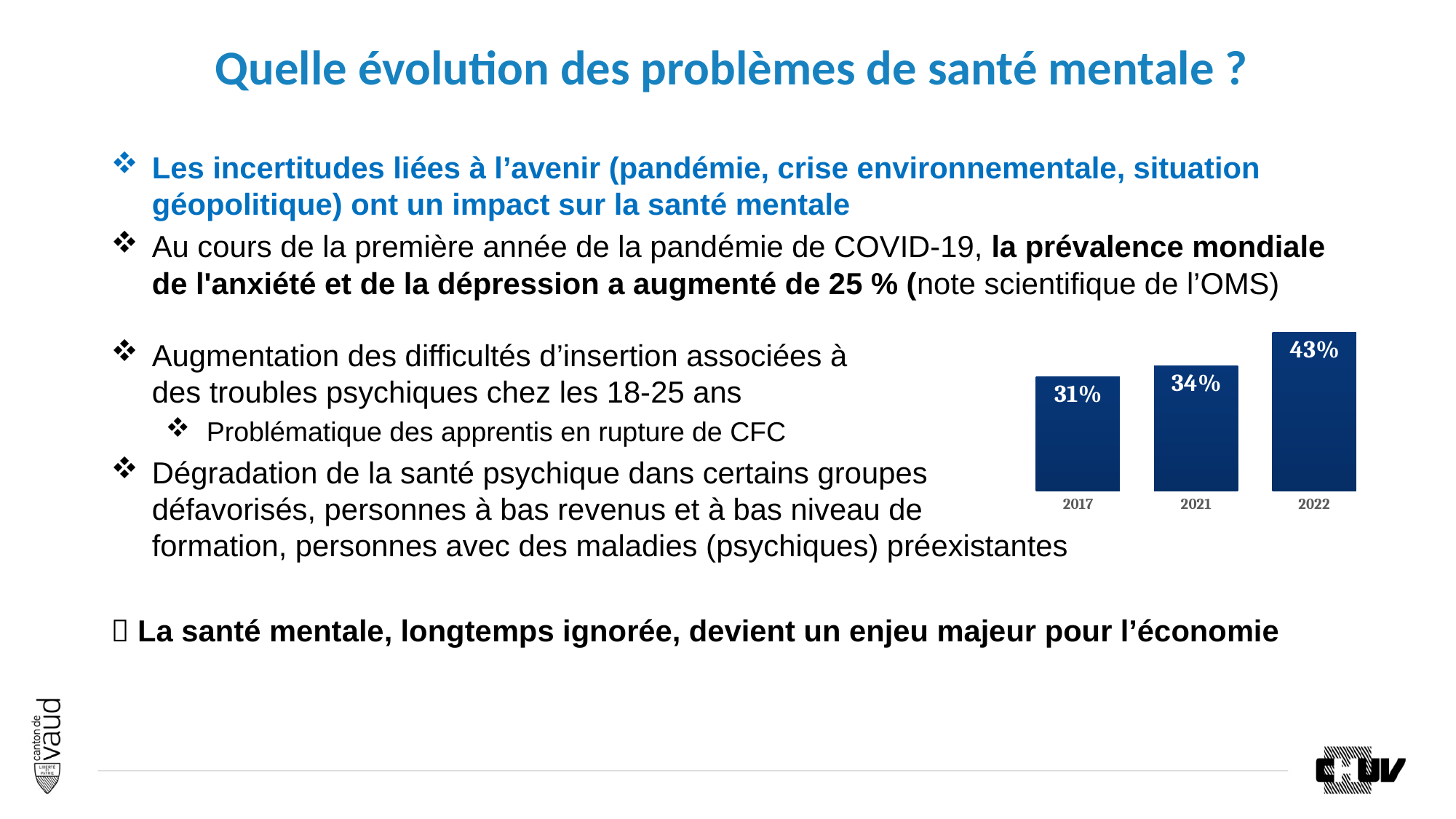
Do the values rise or fall from 2017 to 2022? Rise What colour are the bars in the chart? Dark blue Which is larger, the value for 2021 or the value for 2022? 2022 What is the value shown for 2017? 31% Which year has the lowest value? 2017 Which year has the highest value? 2022 How many bars are in the chart? 3 What is the value shown for 2022? 43% What is the difference between the values for 2021 and 2017? 3% What is the value shown for 2021? 34% What kind of chart is shown on the slide? Bar chart What is the difference between the values for 2022 and 2017? 12%